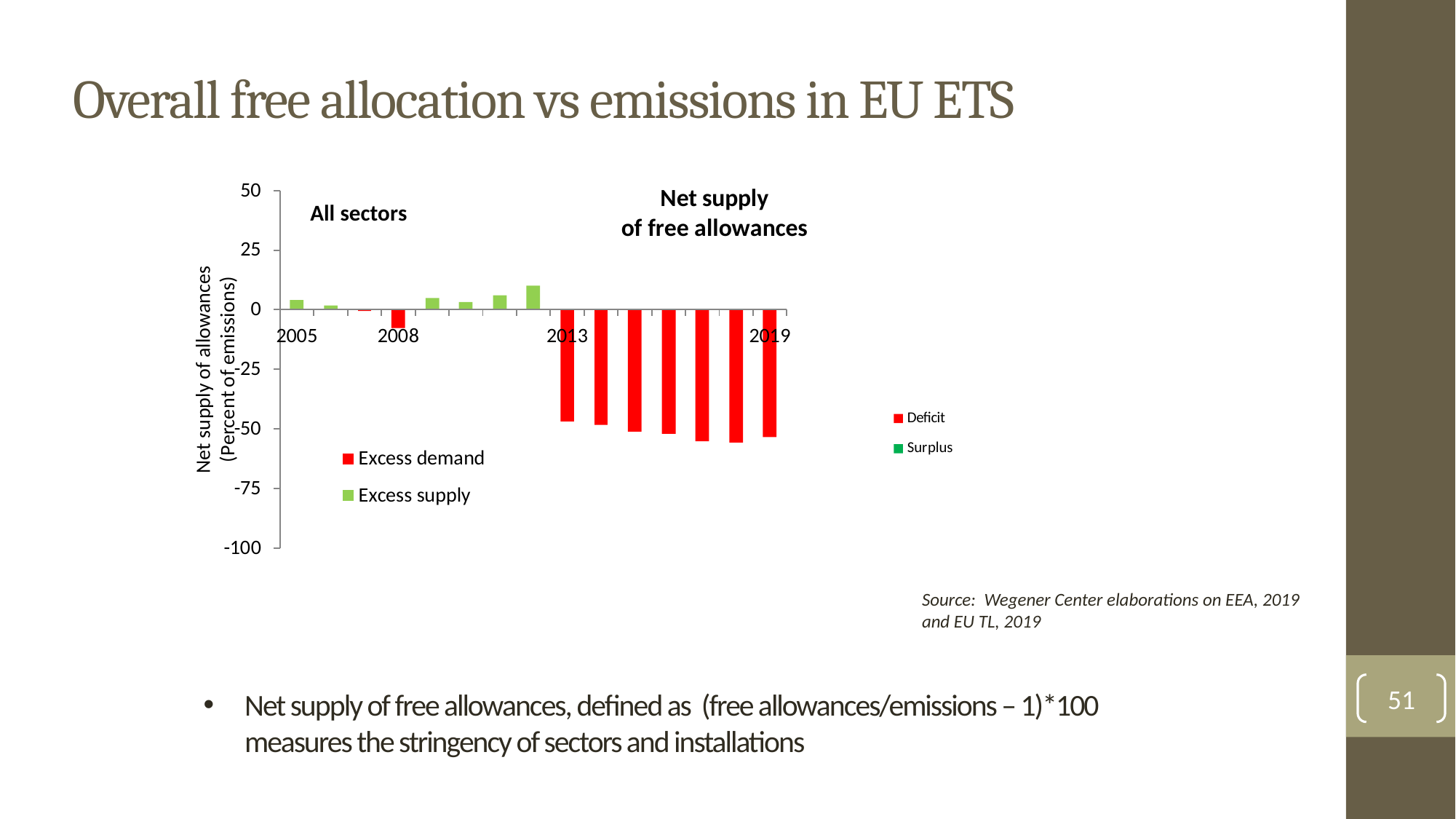
What are the two legend entries shown inside the chart? Excess demand, Excess supply How many years from 2013 to 2019 show excess demand (red bars)? 7 Is the value for 2013 greater or less than -25? less Is the value for 2008 greater or less than 0? less Are the bars from 2013 to 2019 positive or negative? Negative Which year shows the larger excess demand, 2008 or 2013? 2013 Is the value for 2013 greater or less than -50? greater What kind of chart is shown on the slide? Bar chart What is the y-axis title of the chart? Net supply of allowances (Percent of emissions)